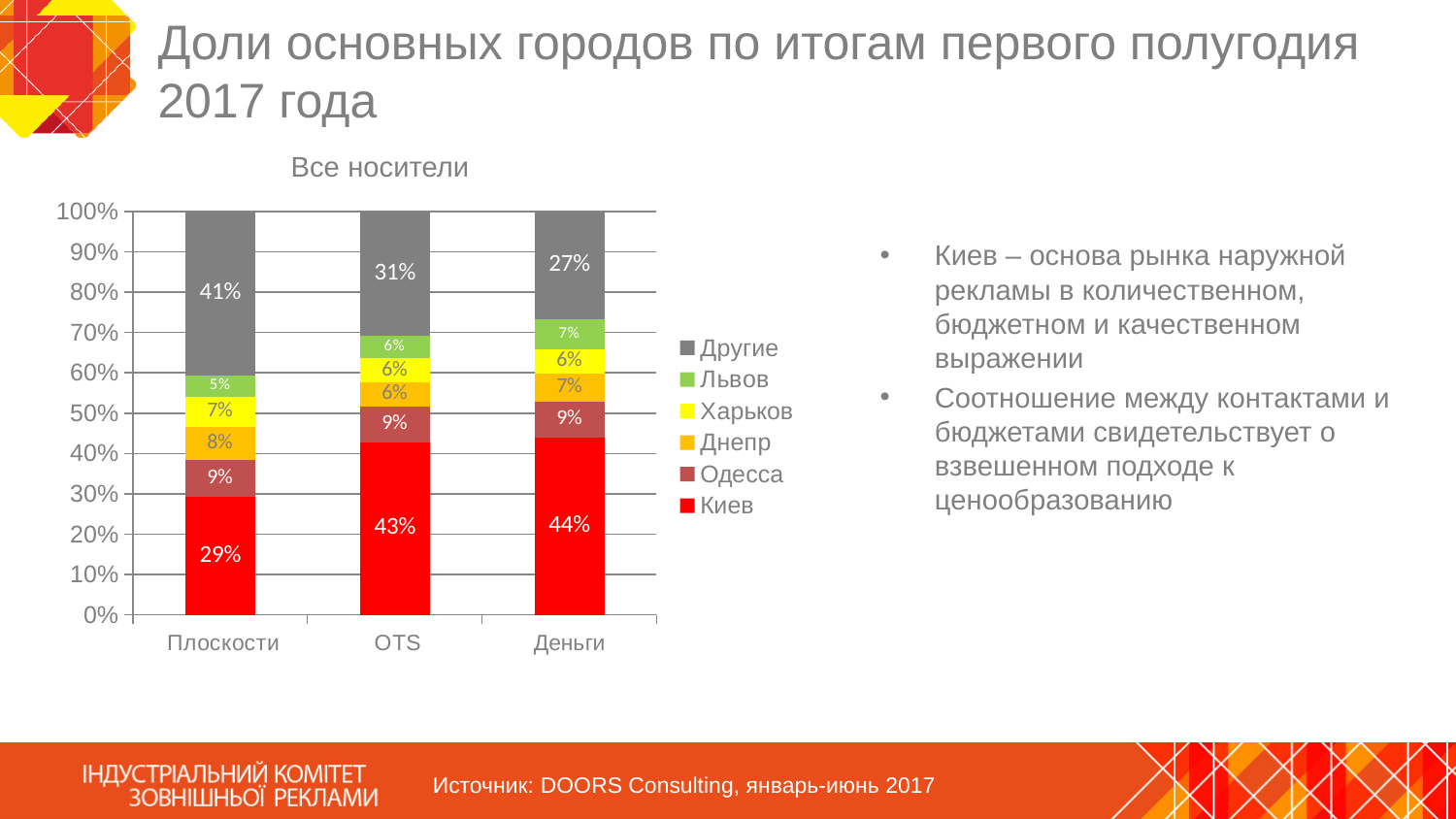
In which category is the share of Киев the highest? Деньги Which is larger: the Другие share in Плоскости or in OTS? Плоскости What is the value for Львов in the OTS bar? 6% What is the title of the chart? Все носители How many series does the chart legend list? 6 What is the value for Киев in the Плоскости bar? 29% In which category is the share of Другие the lowest? Деньги What is the value for Днепр in the Плоскости bar? 8% What kind of chart is shown on the slide? Stacked bar chart What is the value for Другие in the Деньги bar? 27% How many categories are shown on the x axis of the chart? 3 What is the difference between the Киев share in Деньги and in Плоскости? 15%